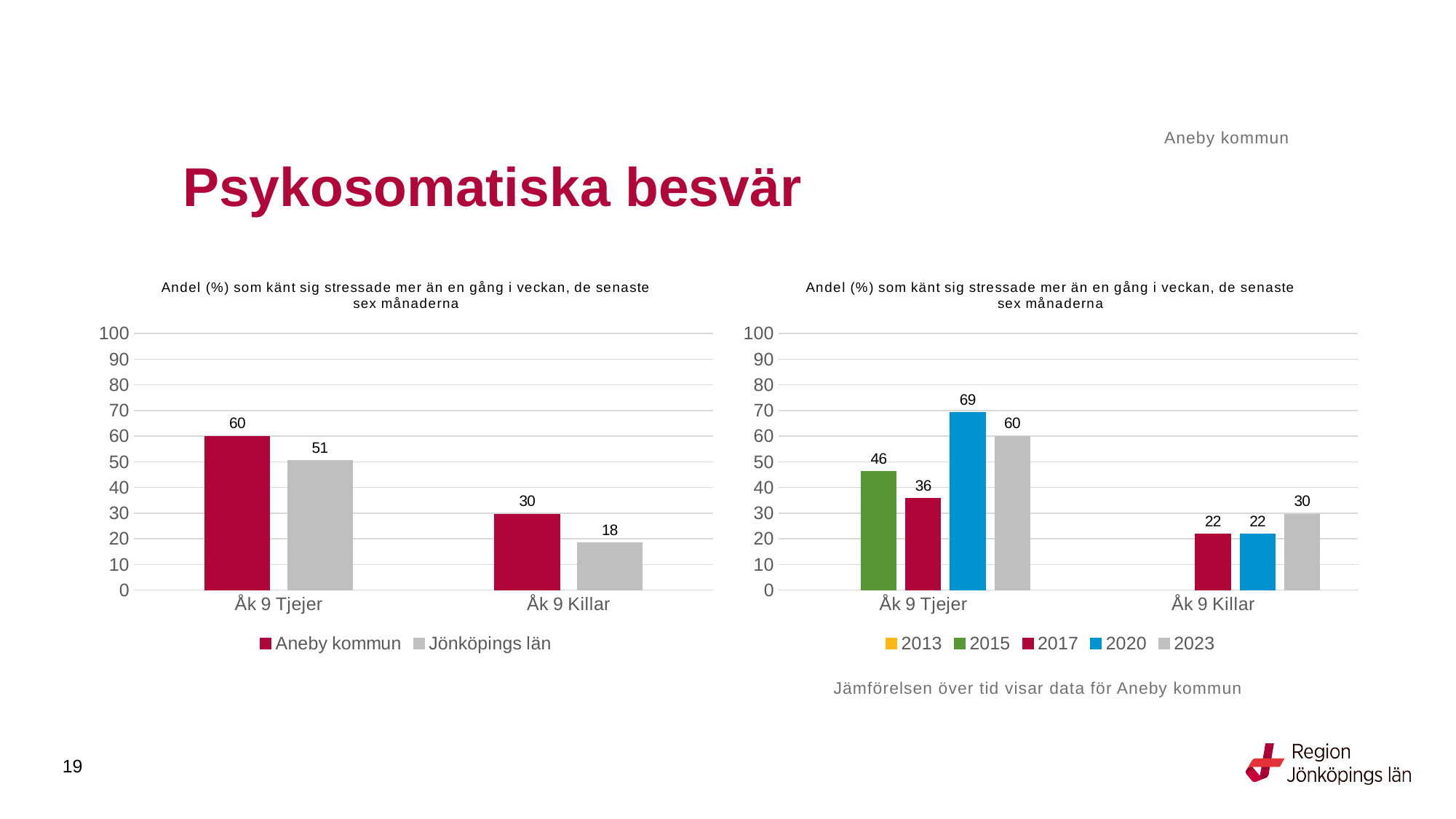
In the right chart, what is the difference between the 2015 and 2017 values for Åk 9 Tjejer? 10 What kind of chart is the left chart? Bar chart In the right chart, what is the value for 2023 for Åk 9 Killar? 30 In the right chart, how many series does the legend list? 5 In the right chart, what is the value for 2020 for Åk 9 Tjejer? 69 In the left chart, what is the value for Aneby kommun for Åk 9 Tjejer? 60 In the right chart, is the value for 2017 for Åk 9 Killar greater or less than 30? less In the left chart, what is the value for Jönköpings län for Åk 9 Killar? 18 In the left chart, what is the difference between Aneby kommun and Jönköpings län for Åk 9 Tjejer? 9 In the left chart, how many series does the legend list? 2 In the right chart, which year has the highest value for Åk 9 Tjejer? 2020 In the left chart, which is larger for Åk 9 Killar: Aneby kommun or Jönköpings län? Aneby kommun